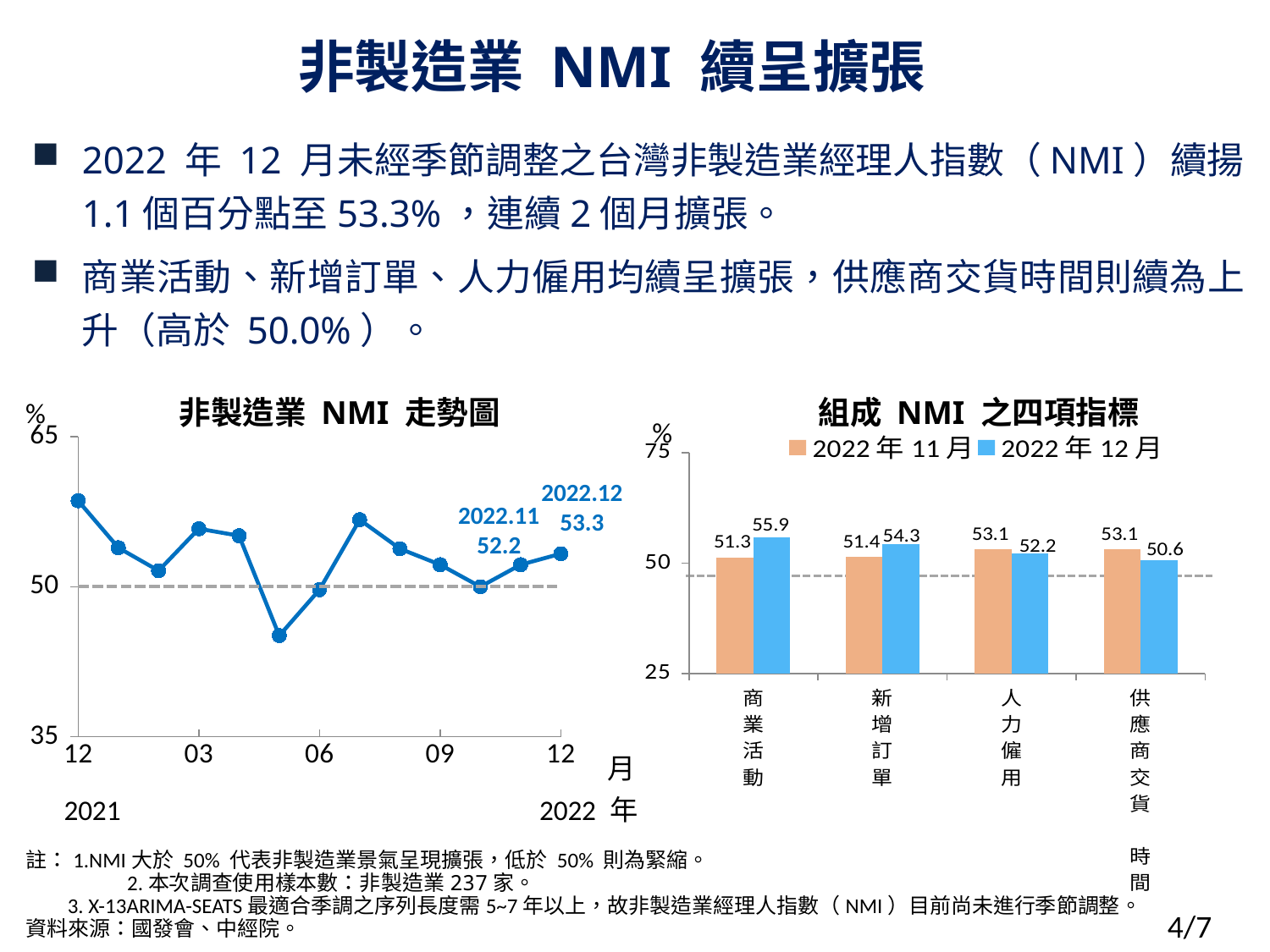
In the chart titled 組成 NMI 之四項指標, what is the difference between the 2022年12月 and 2022年11月 values for 新增訂單? 2.9 In the chart titled 非製造業 NMI 走勢圖, what is the difference between the 2022.12 and 2022.11 values? 1.1 In the chart titled 非製造業 NMI 走勢圖, what is the NMI value for 2022.12? 53.3 In the chart titled 組成 NMI 之四項指標, which category has the lowest 2022年12月 value? 供應商交貨時間 In the chart titled 組成 NMI 之四項指標, what is the 2022年12月 value for 商業活動? 55.9 In the chart titled 非製造業 NMI 走勢圖, what is the NMI value for 2022.11? 52.2 In the chart titled 非製造業 NMI 走勢圖, is the value for month 05 of 2022 greater or less than 50? less In the chart titled 組成 NMI 之四項指標, how many series does the legend list? 2 In the chart titled 組成 NMI 之四項指標, what is the 2022年11月 value for 供應商交貨時間? 53.1 In the chart titled 組成 NMI 之四項指標, which is larger for 人力僱用: the 2022年11月 value or the 2022年12月 value? 2022年11月 In the chart titled 組成 NMI 之四項指標, which category has the highest 2022年12月 value? 商業活動 In the chart titled 非製造業 NMI 走勢圖, what kind of chart is shown? line chart